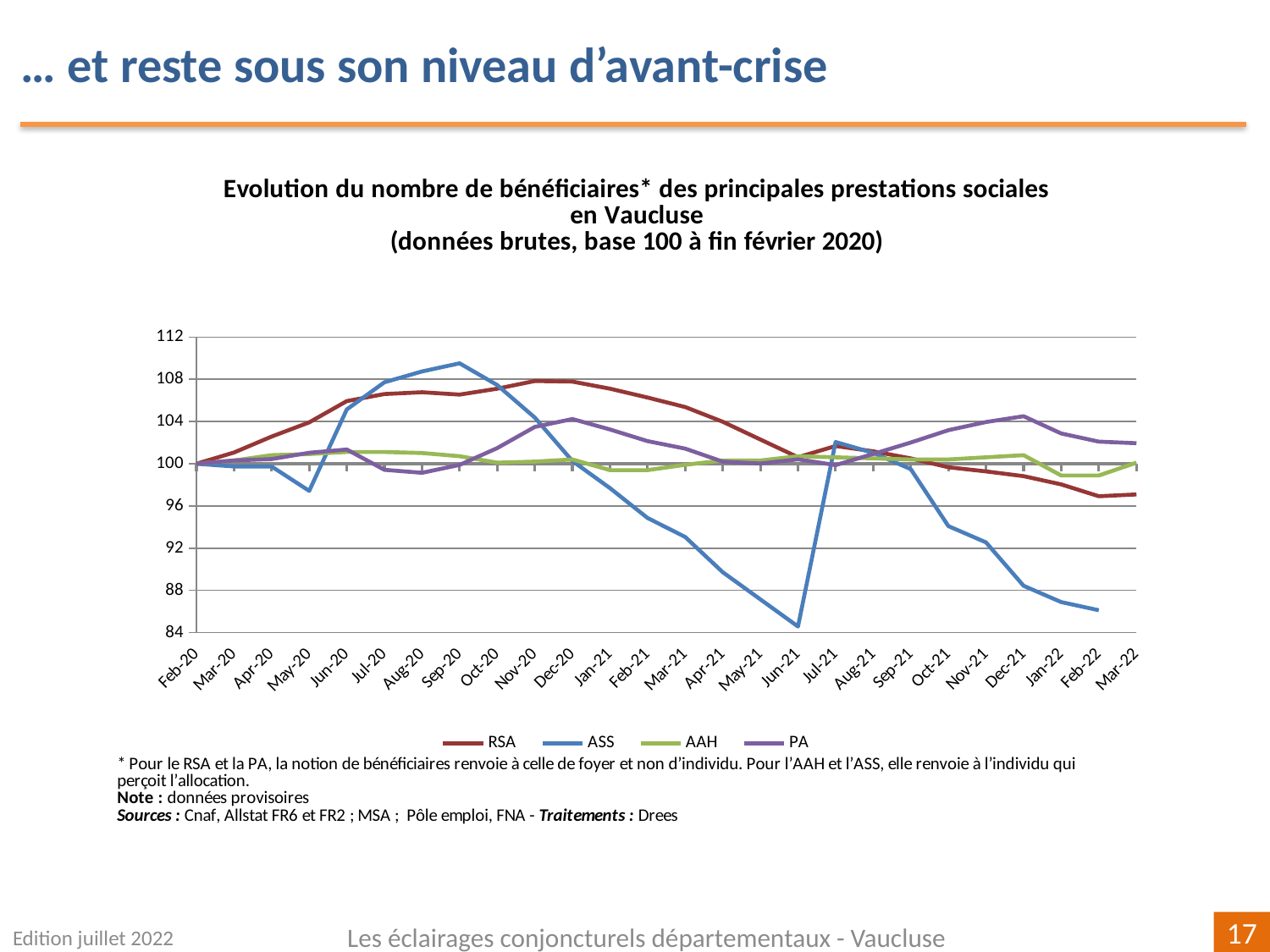
How many series does the legend list? 4 Does the RSA series rise or fall between Dec-20 and Mar-22? fall Is the value for RSA in Mar-22 greater or less than 100? less Which series reaches the lowest value on the chart? ASS Which series has the highest value in Mar-22? PA Which series reaches the highest value on the chart? ASS Is the value for ASS in Sep-20 greater or less than 108? greater Is the value for ASS in Jun-21 greater or less than 88? less What kind of chart is shown on the slide? line chart How many monthly points are plotted along the x axis? 26 What is the base period for the index of 100 according to the chart title? fin février 2020